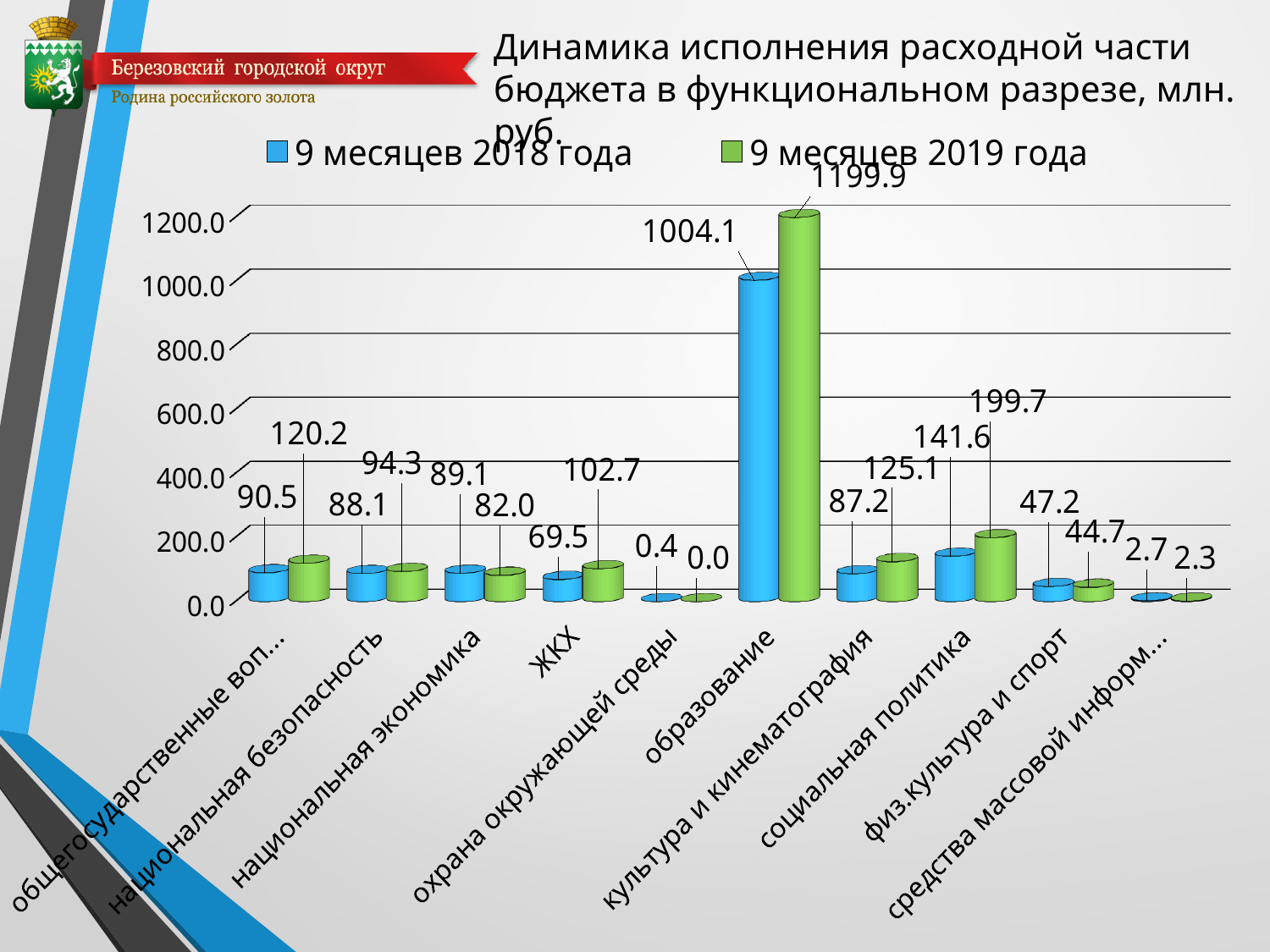
What is the difference between the 9 месяцев 2019 года and 9 месяцев 2018 года values for образование? 195.8 For национальная экономика, which series has the larger value: 9 месяцев 2018 года or 9 месяцев 2019 года? 9 месяцев 2018 года How many categories are shown on the x axis? 10 What is the value for образование in the series 9 месяцев 2018 года? 1004.1 Is the value for социальная политика in the series 9 месяцев 2018 года greater or less than 200.0? less What is the value for ЖКХ in the series 9 месяцев 2019 года? 102.7 Which category has the lowest value in the series 9 месяцев 2019 года? охрана окружающей среды How many series does the legend list? 2 What is the value for культура и кинематография in the series 9 месяцев 2018 года? 87.2 Which category has the highest value in the series 9 месяцев 2019 года? образование What kind of chart is shown on the slide? bar chart What is the value for социальная политика in the series 9 месяцев 2019 года? 199.7